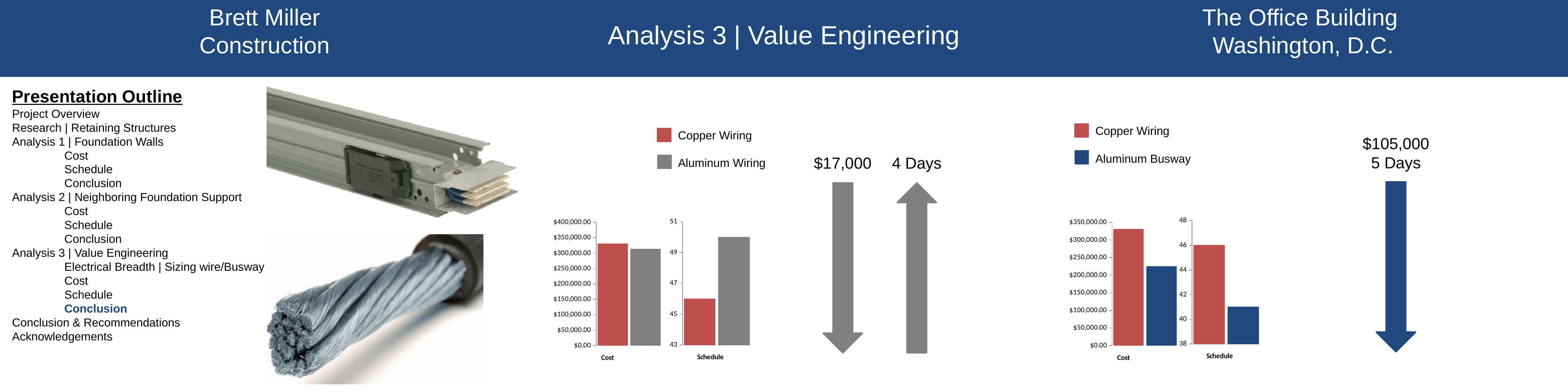
What kind of chart is the Cost chart on the left (Copper Wiring vs Aluminum Wiring)? bar chart In the right Cost chart, is the value for Aluminum Busway greater or less than $250,000.00? less In the right Schedule chart, which series has the lower value, Copper Wiring or Aluminum Busway? Aluminum Busway In the left Schedule chart, which series has the higher value, Copper Wiring or Aluminum Wiring? Aluminum Wiring How many series does the legend for the left pair of charts list? 2 What are the two series named in the legend for the right pair of charts? Copper Wiring and Aluminum Busway In the left Schedule chart, is the value for Aluminum Wiring greater or less than 49? greater In the left Cost chart, is the value for Copper Wiring greater or less than $300,000.00? greater In the right Cost chart, which series has the higher value, Copper Wiring or Aluminum Busway? Copper Wiring